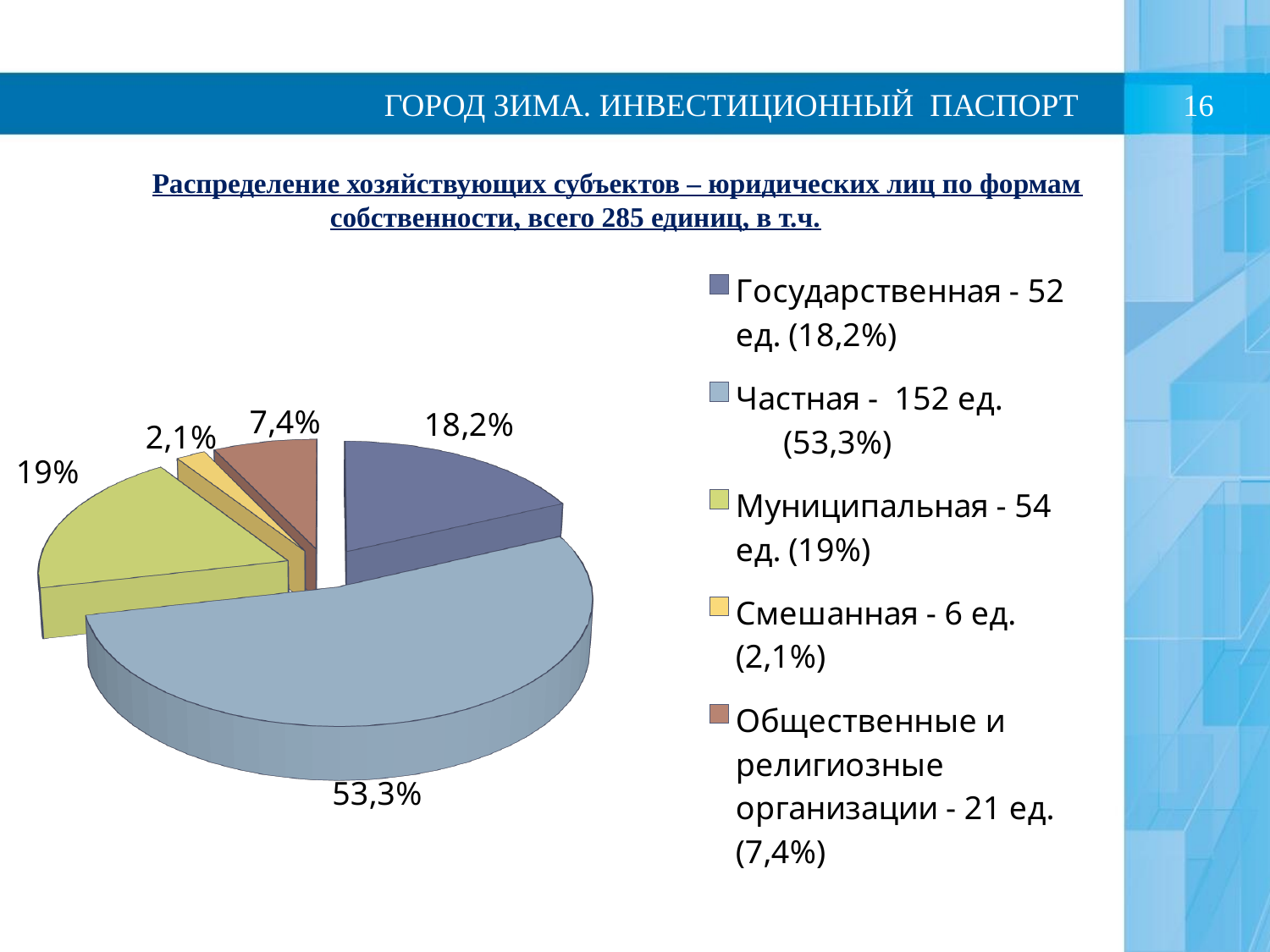
How many slices does the pie chart have? 5 What percentage share does the Смешанная slice have? 2,1% What percentage share does the Частная slice have? 53,3% Which category has the smallest share of the pie? Смешанная What is the difference in percentage points between the Частная share and the Государственная share? 35,1 Which category has the largest share of the pie? Частная Which is larger, the share for Государственная or the share for Муниципальная? Муниципальная How many units does the legend give for Муниципальная? 54 ед. What kind of chart is shown on the slide? pie chart What percentage share do Общественные и религиозные организации have? 7,4% What percentage share does the Государственная slice have? 18,2% What percentage share does the Муниципальная slice have? 19%